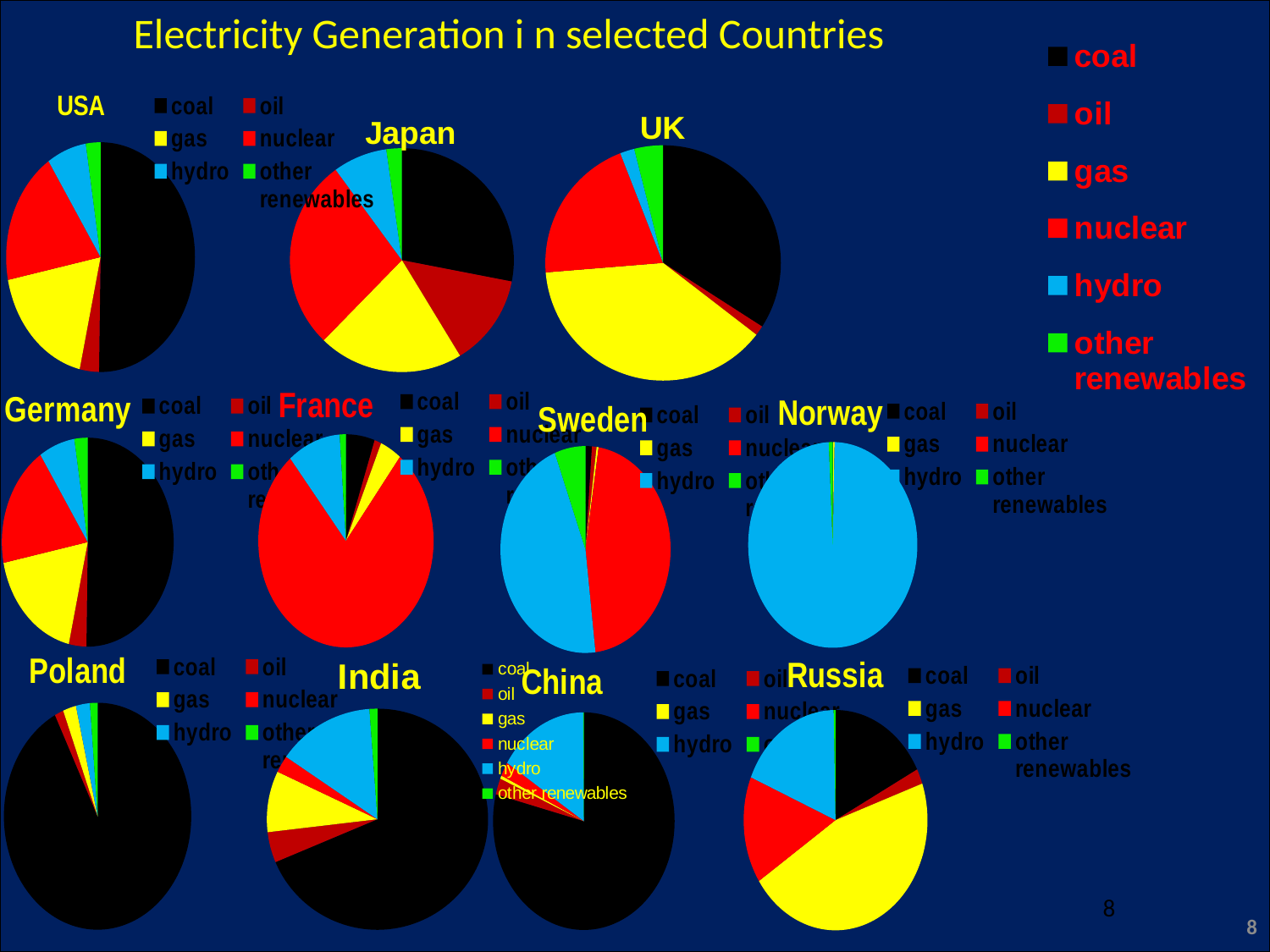
How many energy sources does the legend on the right of the slide list? 6 In the Russia pie chart, which energy source has the largest share? gas In the Germany pie chart, which has the larger share, coal or gas? coal In the UK pie chart, which energy source has the largest share? gas How many countries have a pie chart on the slide? 11 In the Poland pie chart, which energy source has the largest share? coal What kind of chart is used to show electricity generation for the USA? pie chart What is the title of the slide? Electricity Generation in selected Countries In the Japan pie chart, which has the larger share, coal or hydro? coal Which colour represents hydro in the pie charts? light blue